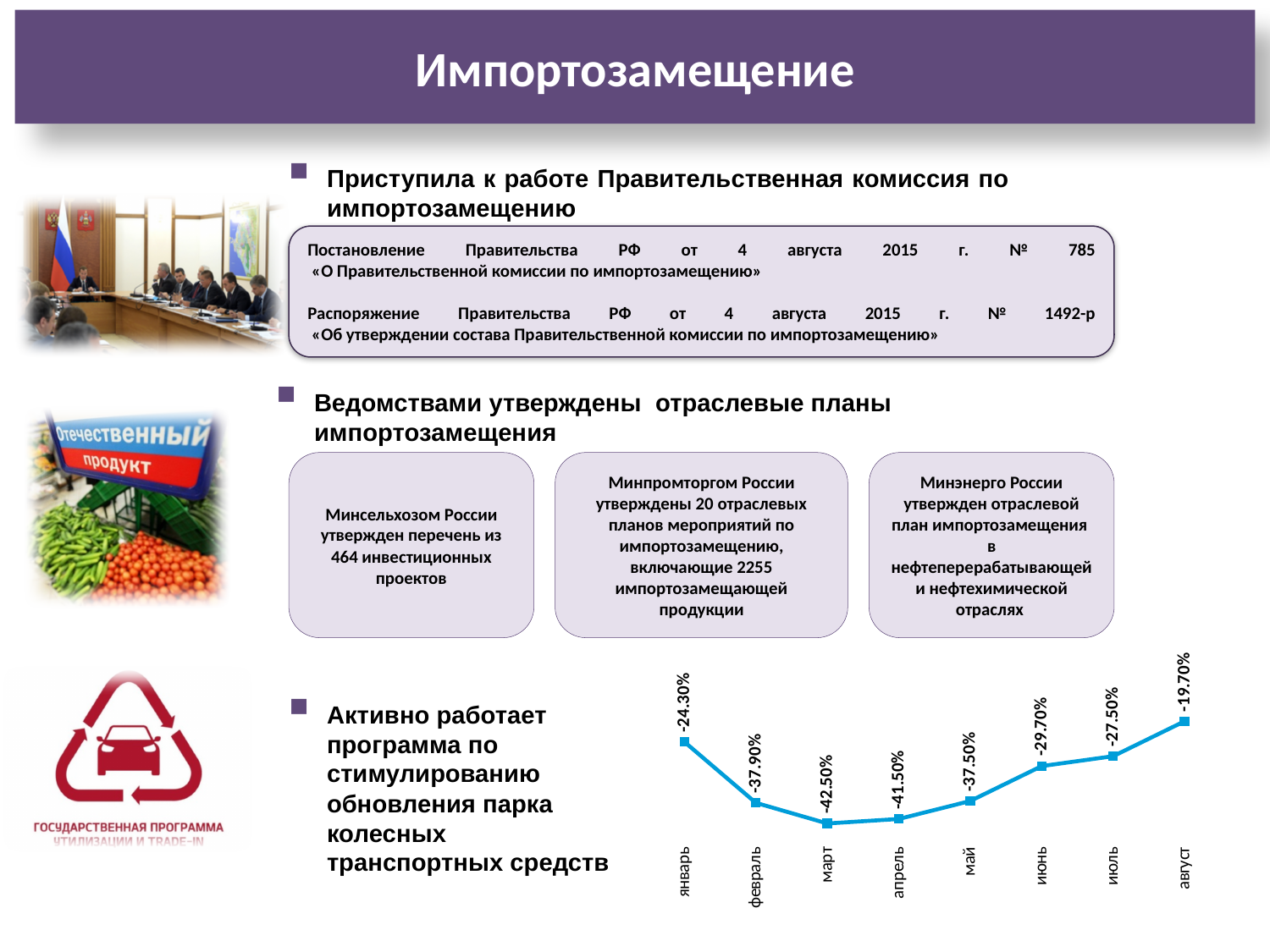
What is the difference between the values for февраль and май on the line chart? 0.40% Which month has the lowest value on the line chart? март How many months are plotted on the line chart? 8 What kind of chart is shown at the bottom right of the slide? line chart What is the value for март on the line chart? -42.50% Do the values on the line chart rise or fall from март to август? rise What is the value for январь on the line chart? -24.30% What is the value for август on the line chart? -19.70% What is the value for июнь on the line chart? -29.70% Which month has the highest value on the line chart? август Which is larger on the line chart, the value for апрель or the value for июль? июль What is the difference between the values for январь and август on the line chart? 4.60%